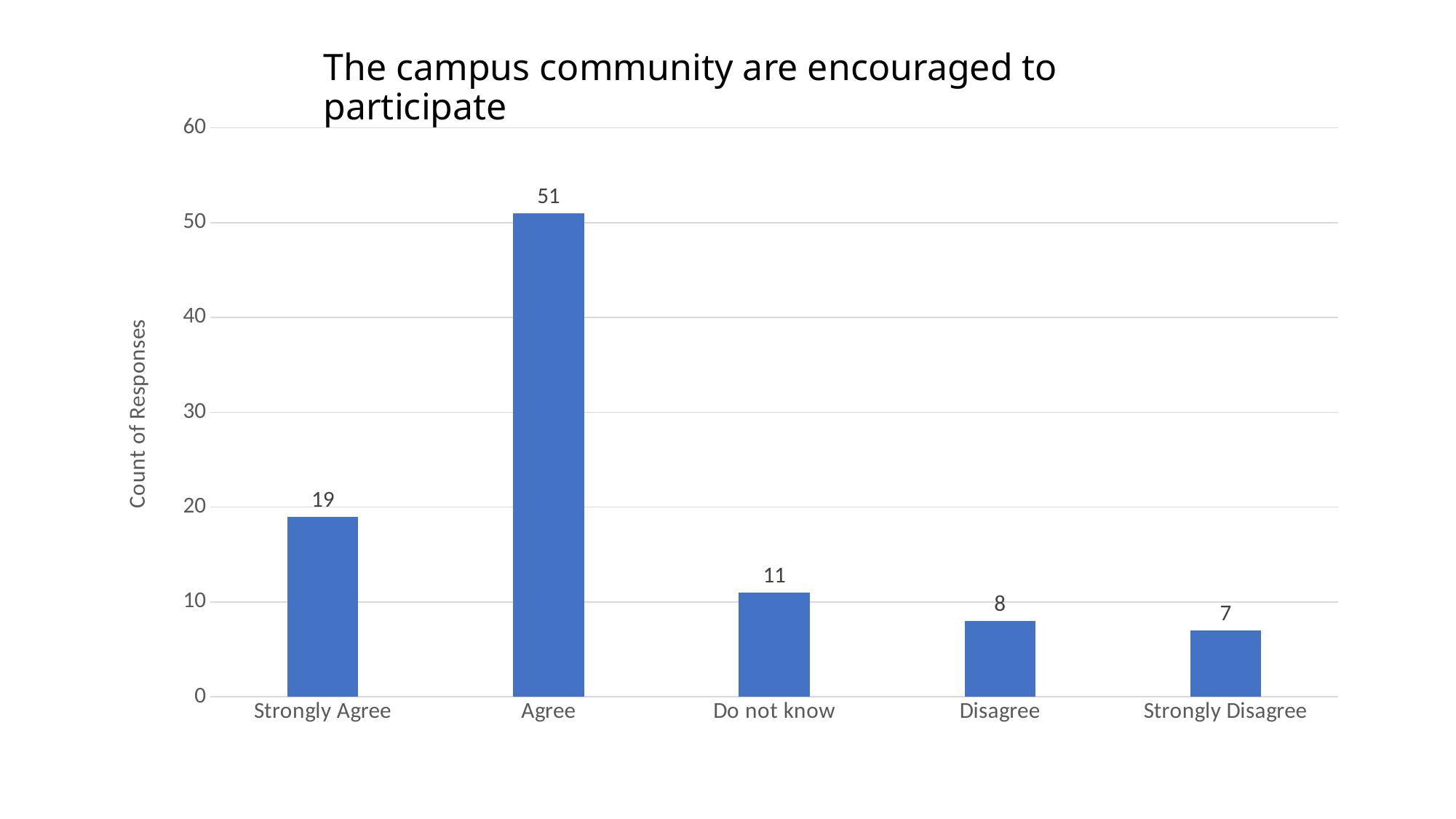
Which category has the lowest count of responses? Strongly Disagree What is the label of the vertical axis? Count of Responses What is the count of responses for Strongly Agree? 19 What is the difference between the counts for Agree and Strongly Agree? 32 What kind of chart is shown on the slide? bar chart What is the count of responses for Agree? 51 What is the count of responses for Strongly Disagree? 7 What is the count of responses for Do not know? 11 Is the value for Strongly Agree greater or less than 20? less Which category has the highest count of responses? Agree How many categories are shown on the x axis? 5 Which has more responses, Disagree or Do not know? Do not know